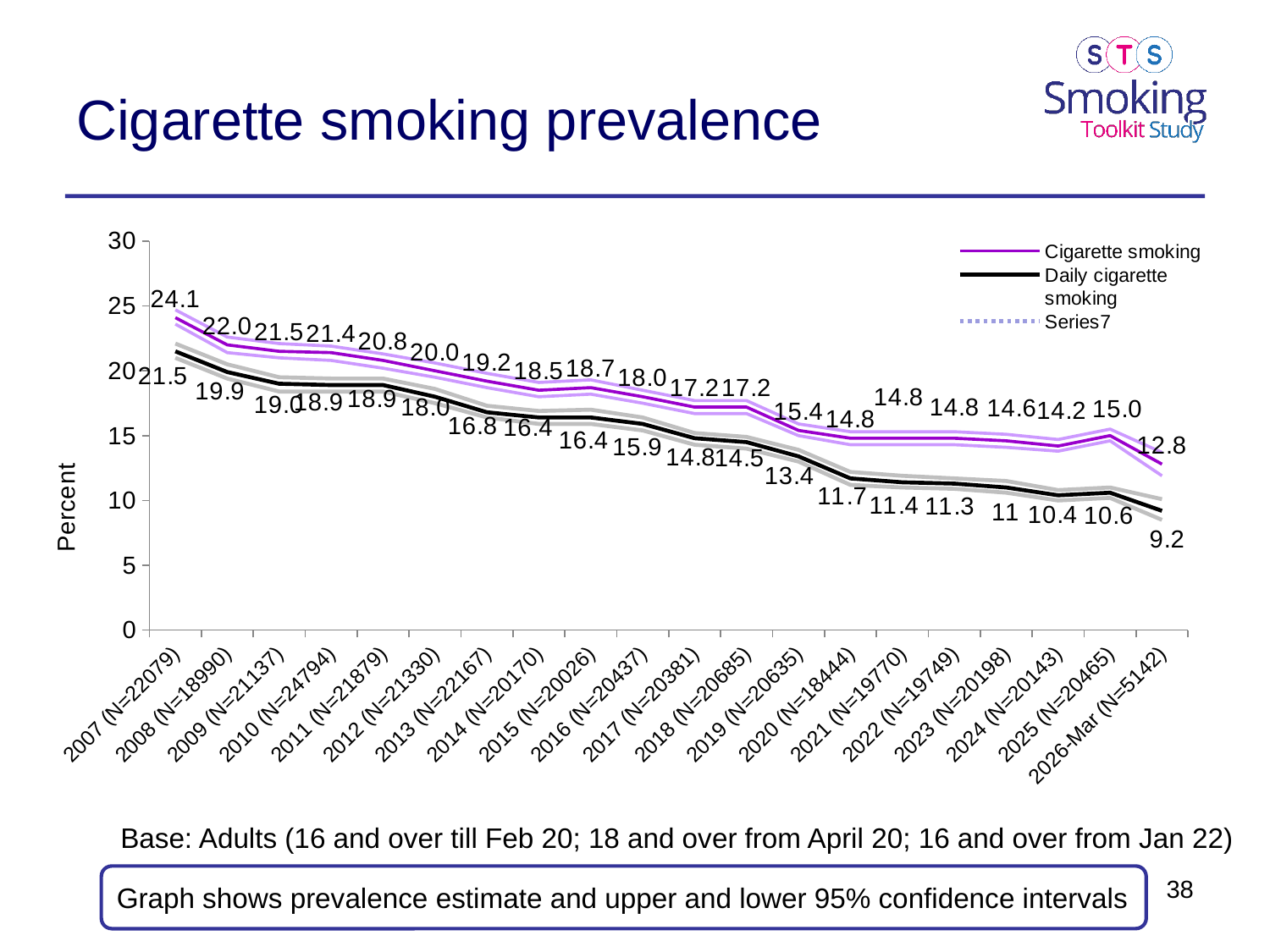
How many time points are plotted on the x axis? 20 What is the daily cigarette smoking prevalence for 2026-Mar? 9.2 Does daily cigarette smoking prevalence generally rise or fall from 2007 to 2026-Mar? Fall What is the difference between cigarette smoking and daily cigarette smoking prevalence in 2007? 2.6 In which year is cigarette smoking prevalence highest? 2007 Which year has the higher cigarette smoking prevalence, 2019 or 2020? 2019 How many series does the legend list? 3 What is the cigarette smoking prevalence for 2007? 24.1 What is the daily cigarette smoking prevalence for 2019? 13.4 In which period is daily cigarette smoking prevalence lowest? 2026-Mar What kind of chart is shown on the slide? Line chart By how much did cigarette smoking prevalence fall from 2025 to 2026-Mar? 2.2